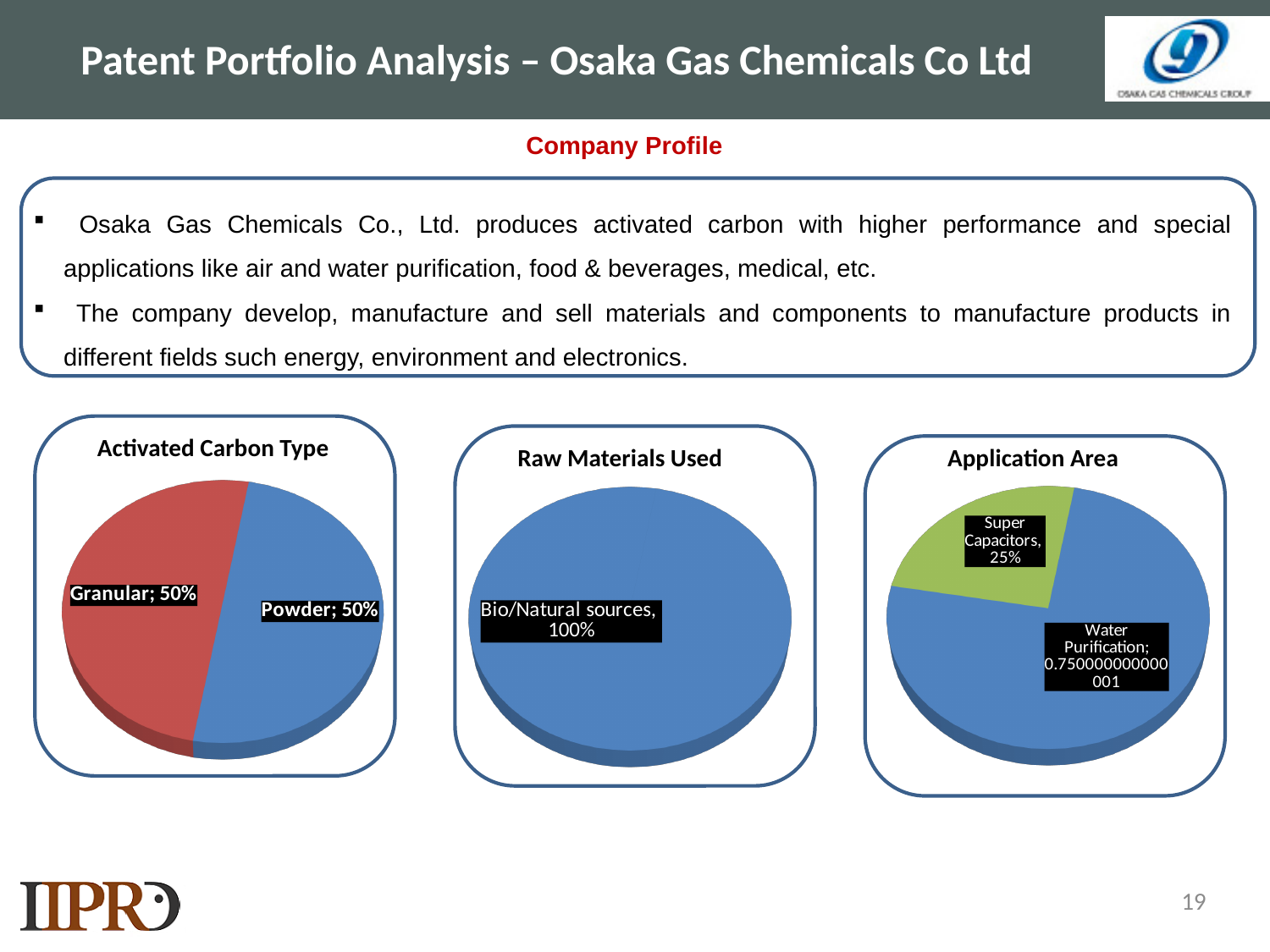
In the Raw Materials Used chart, what share does Bio/Natural sources have? 100% In the Activated Carbon Type chart, what share does Granular have? 50% In the Application Area chart, which application area has the smallest slice? Super Capacitors What is the title of the middle chart on the slide? Raw Materials Used What kind of chart is the Activated Carbon Type chart? Pie chart In the Application Area chart, what share does Super Capacitors have? 25% How many categories are shown in the Raw Materials Used chart? 1 How many slices does the Application Area chart have? 2 How many slices does the Activated Carbon Type chart have? 2 In the Activated Carbon Type chart, what share does Powder have? 50% In the Application Area chart, which application area has the largest slice? Water Purification In the Application Area chart, which is larger: Water Purification or Super Capacitors? Water Purification